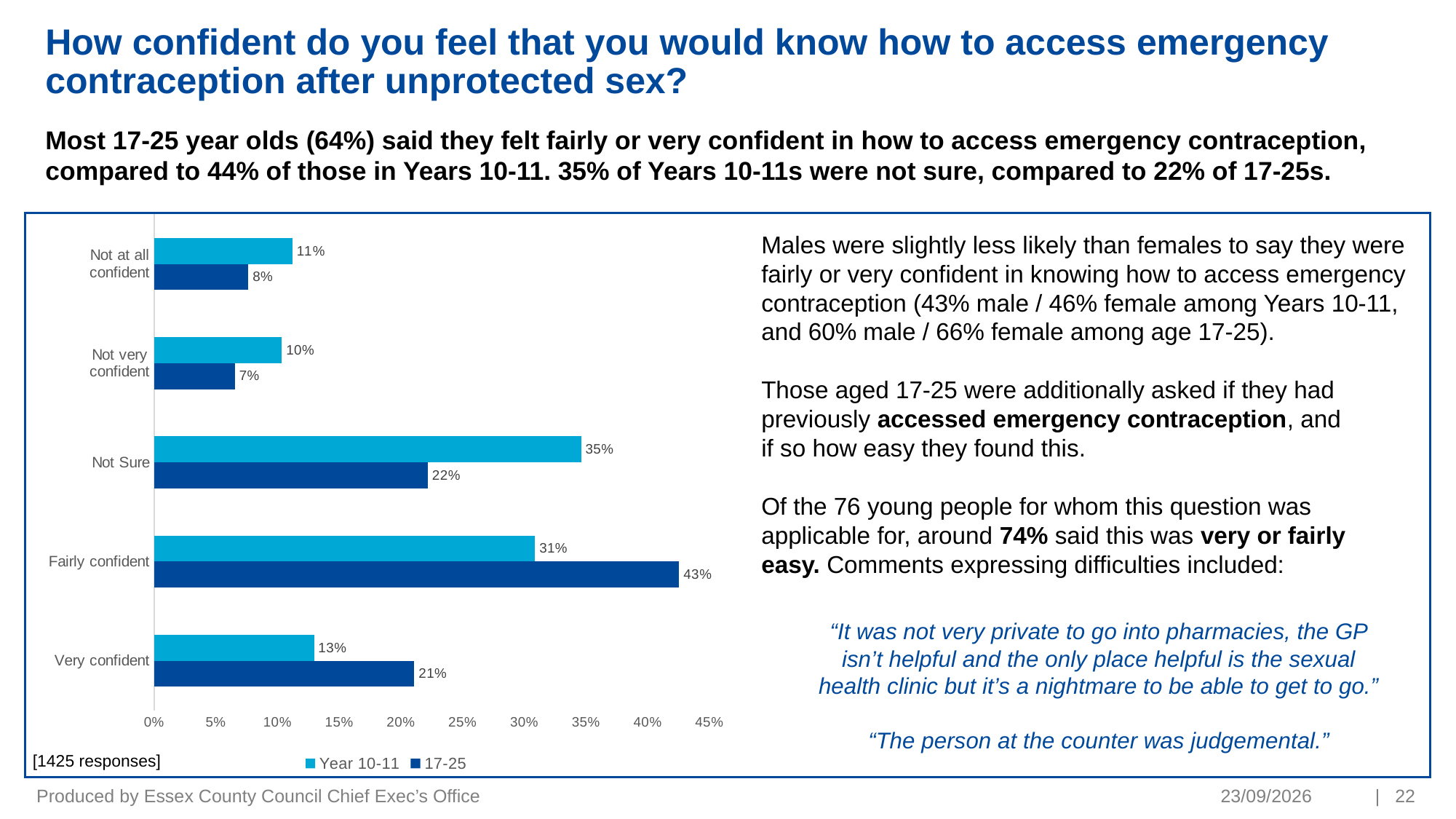
What percentage of 17-25 year olds said they were Very confident? 21% What percentage of Year 10-11 respondents said they were Not at all confident? 11% How many series does the legend list? 2 For Very confident, which series has the larger value: Year 10-11 or 17-25? 17-25 What kind of chart is shown on the slide? Bar chart What percentage of 17-25 year olds said they were Fairly confident? 43% How many response categories are shown on the chart? 5 What is the difference between the Year 10-11 and 17-25 values for Not Sure? 13% Which category has the highest value for the 17-25 series? Fairly confident How many responses does the chart note say it is based on? 1425 responses Which category has the lowest value for the 17-25 series? Not very confident What percentage of Year 10-11 respondents said they were Not Sure? 35%